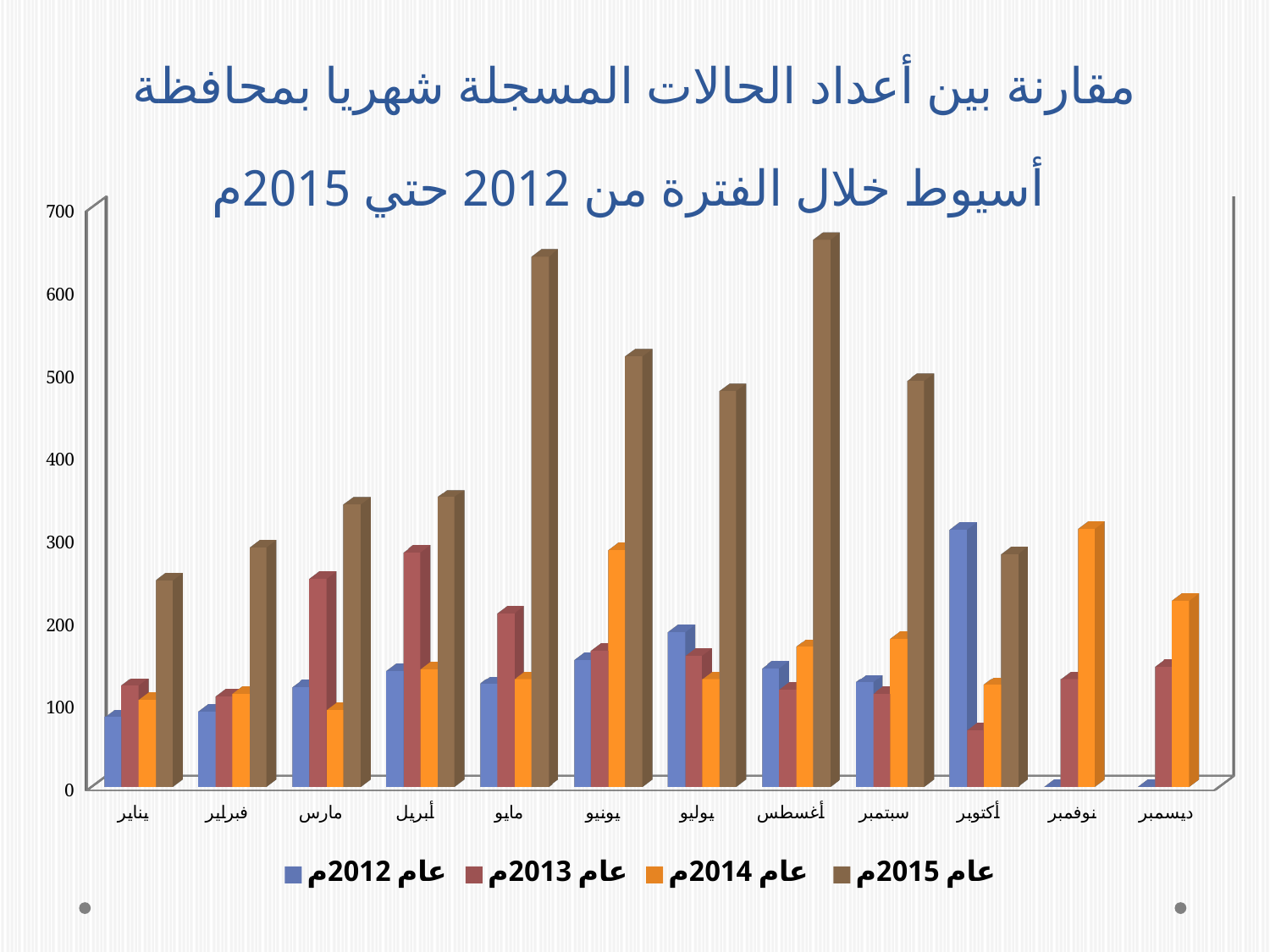
In which month is the value for عام 2012م highest? أكتوبر Is the value for عام 2013م in أبريل greater or less than 200? greater Which series does the brown bar represent? عام 2015م How many months (categories) are shown on the x axis? 12 Which is larger for عام 2015م: the value in مايو or the value in يناير? مايو What kind of chart is shown on the slide? bar chart Is the value for عام 2014م in مارس greater or less than 200? less Is the value for عام 2015م in يناير greater or less than 300? less Do the values for عام 2015م rise or fall from يناير to أبريل? rise Which is larger in مارس: the value for عام 2013م or the value for عام 2014م? عام 2013م How many series does the legend list? 4